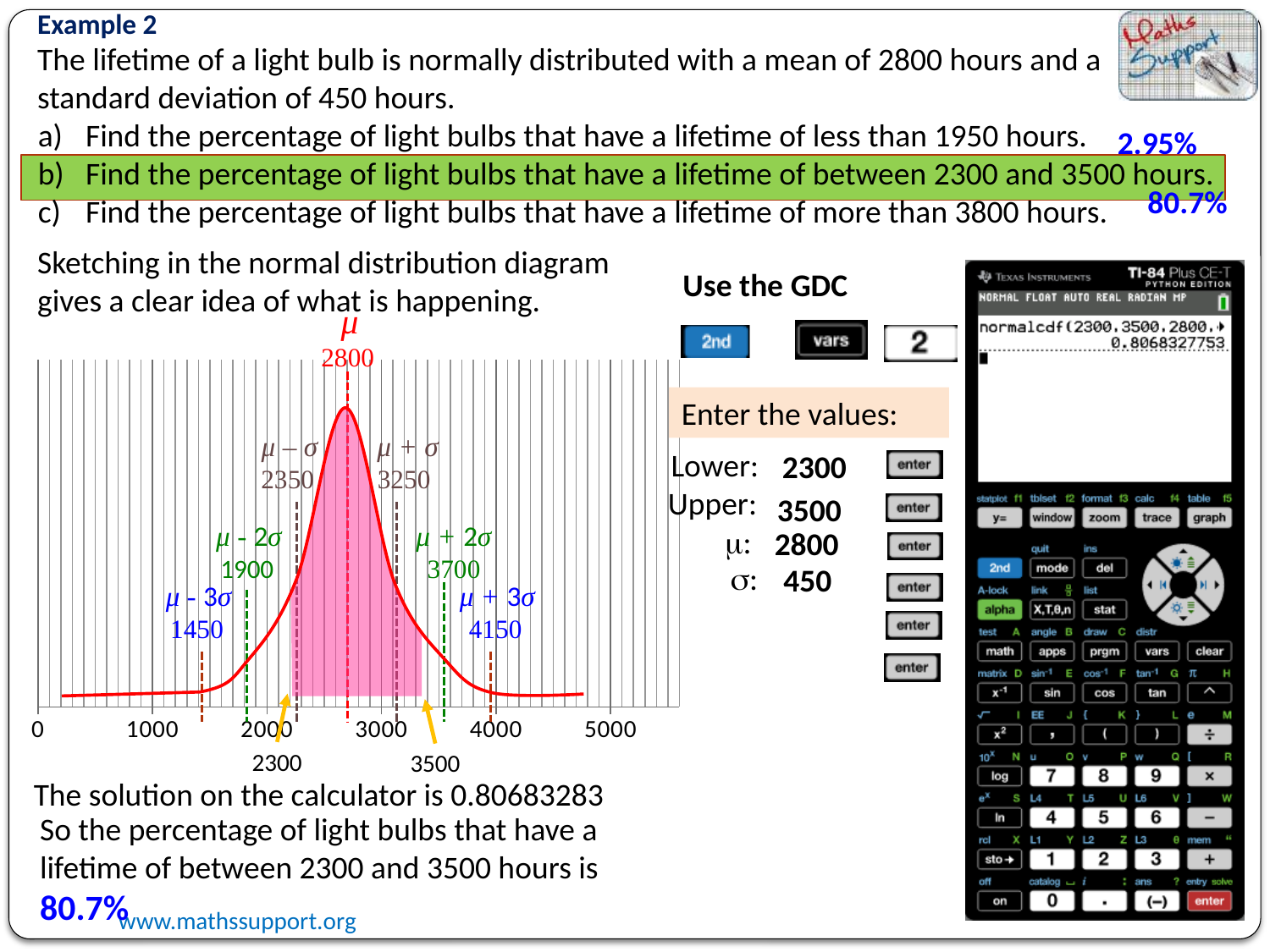
What colour is the shaded region under the curve on the normal distribution diagram? Pink On the normal distribution diagram, is the value labelled at μ − 3σ greater or less than 2000? less On the normal distribution diagram, what is the upper boundary value of the shaded region? 3500 How many labelled tick values are shown on the x axis of the normal distribution diagram? 6 On the normal distribution diagram, what is the difference between the values labelled at μ + σ and μ − σ? 900 On the normal distribution diagram, what value is labelled at μ − 3σ? 1450 On the normal distribution diagram, what value is labelled at μ − 2σ? 1900 On the normal distribution diagram, what value is labelled at μ + 3σ? 4150 On the normal distribution diagram, what value is labelled at the mean μ? 2800 On the normal distribution diagram, what is the lower boundary value of the shaded region? 2300 On the normal distribution diagram, what value is labelled at μ + σ? 3250 What kind of chart is the normal distribution diagram? Line chart (normal distribution curve)